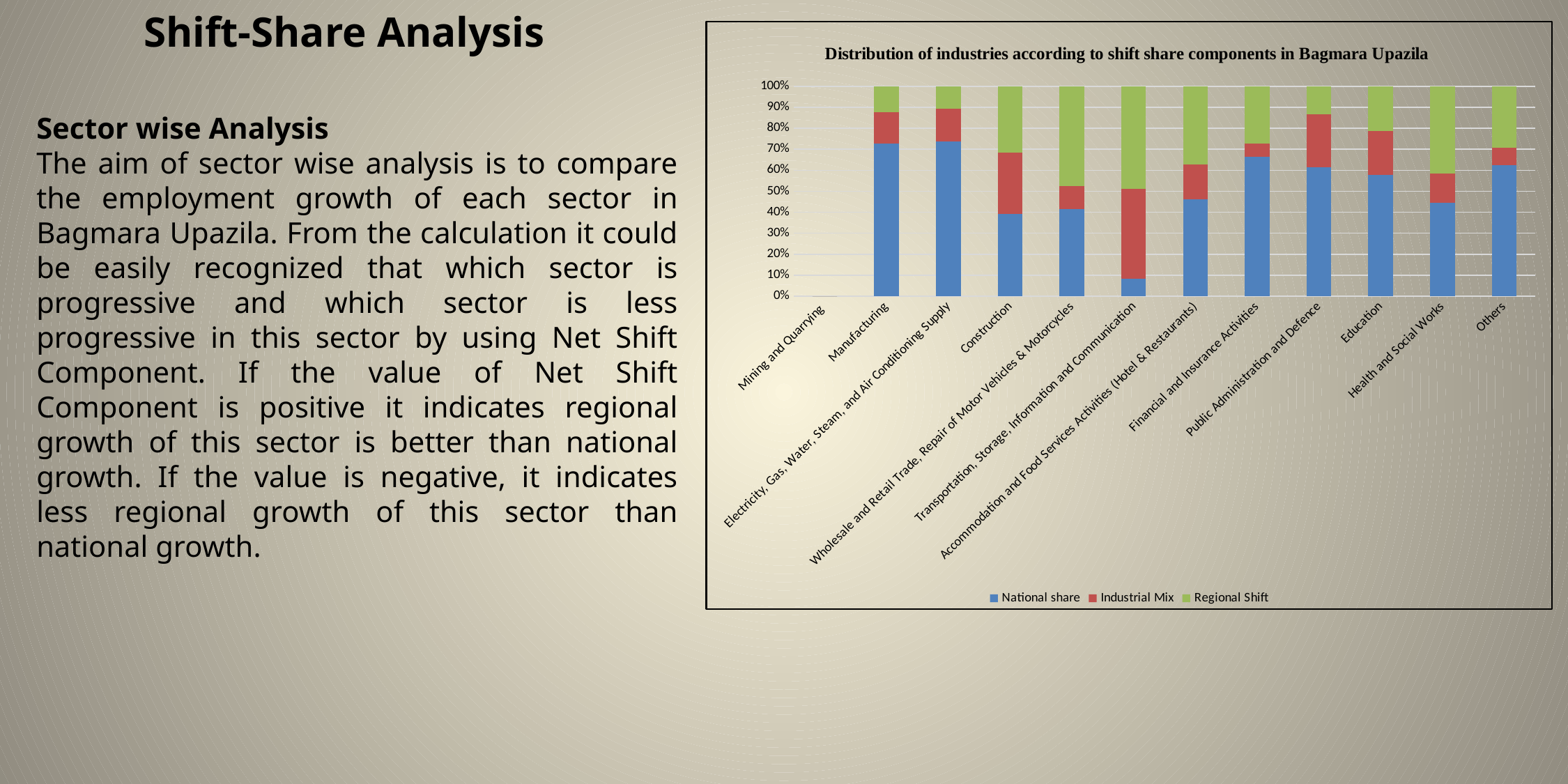
Is the National share value for Construction greater or less than 50%? less Is the National share value for Public Administration and Defence greater or less than 50%? greater Which has the larger National share, Manufacturing or Accommodation and Food Services Activities (Hotel & Restaurants)? Manufacturing What is the title of the chart? Distribution of industries according to shift share components in Bagmara Upazila Which has the larger Regional Shift share, Construction or Manufacturing? Construction Which series is shown in green in the chart? Regional Shift Which has the larger Industrial Mix share, Accommodation and Food Services Activities (Hotel & Restaurants) or Financial and Insurance Activities? Accommodation and Food Services Activities (Hotel & Restaurants) How many series does the chart legend list? 3 Is the National share value for Manufacturing greater or less than 60%? greater How many industry categories are labelled on the x axis of the chart? 12 What kind of chart is shown on the slide? Stacked bar chart